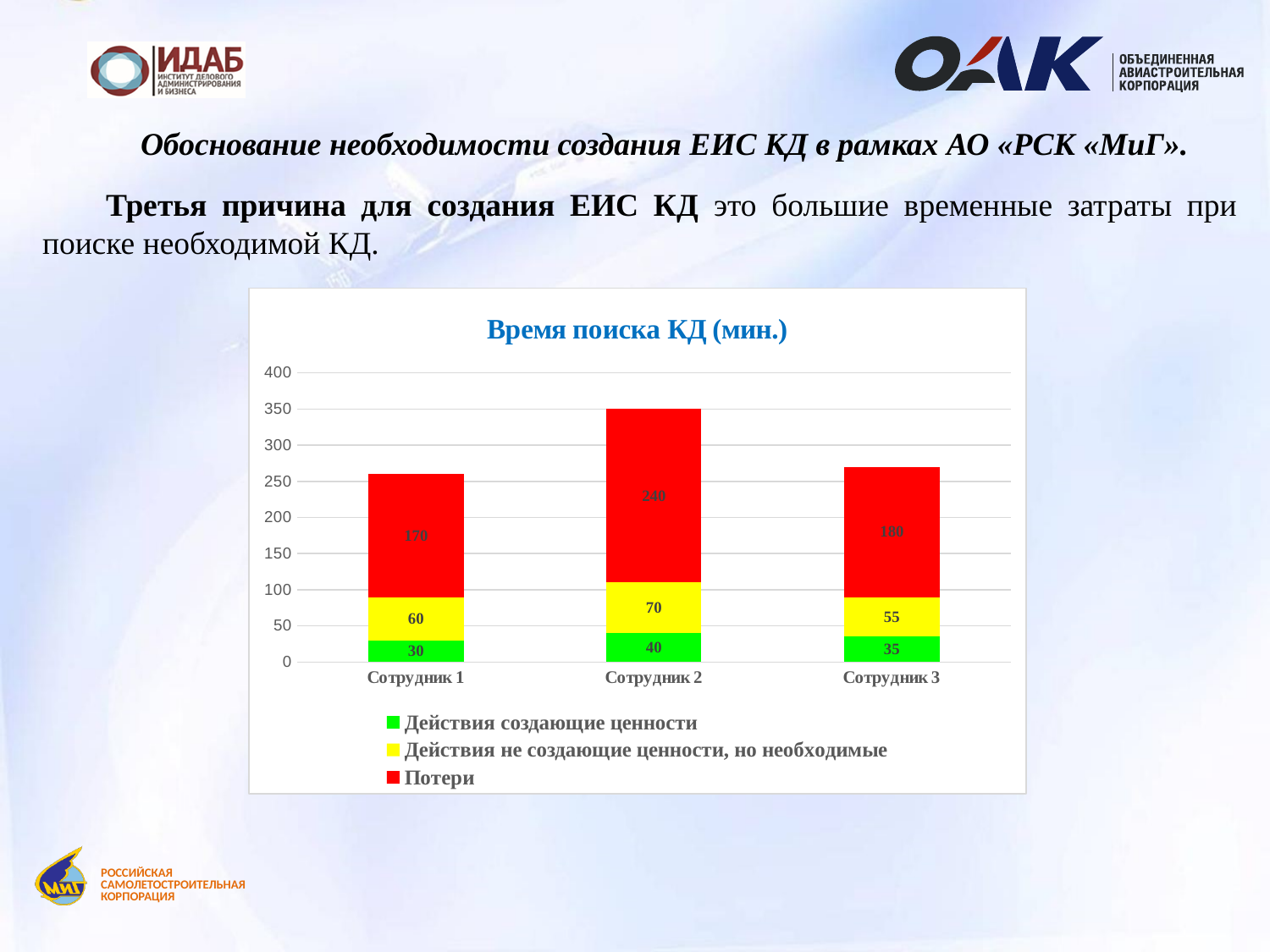
What is the value of "Действия создающие ценности" for Сотрудник 3? 35 What is the difference between the "Потери" values for Сотрудник 2 and Сотрудник 1? 70 How many employees (categories) are shown on the x axis? 3 How many series does the legend list? 3 What is the title of the chart? Время поиска КД (мин.) Which is larger: "Действия не создающие ценности, но необходимые" for Сотрудник 2 or for Сотрудник 3? Сотрудник 2 What is the total of the stacked bar for Сотрудник 1? 260 What is the total of the stacked bar for Сотрудник 2? 350 Which employee has the lowest value for "Действия создающие ценности"? Сотрудник 1 What is the value of "Действия не создающие ценности, но необходимые" for Сотрудник 1? 60 Which employee has the highest value for "Потери"? Сотрудник 2 What is the value of "Потери" for Сотрудник 2? 240